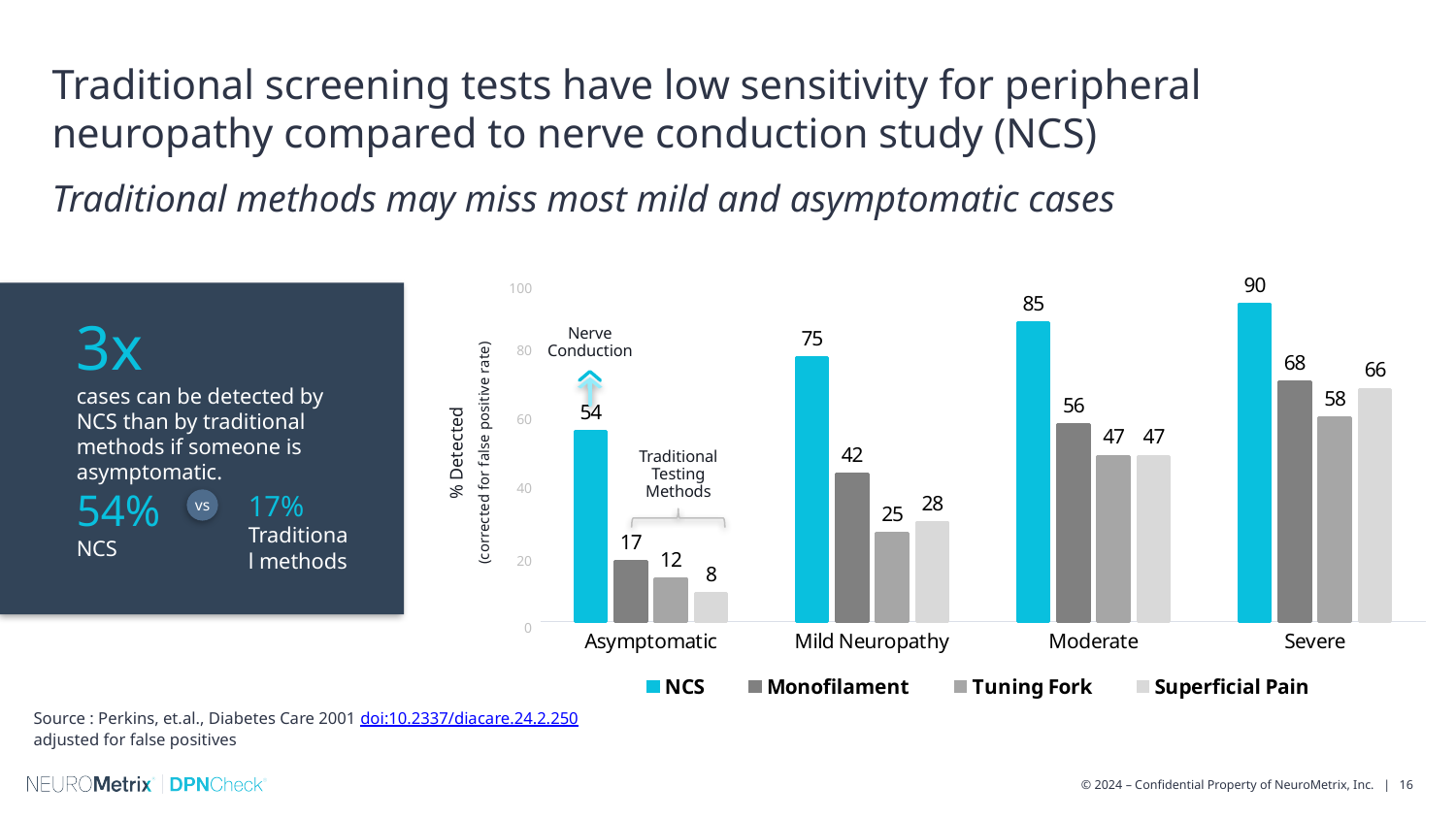
What is the difference between the NCS and Monofilament values for Moderate? 29 What kind of chart is shown on the slide? Bar chart Do the NCS values rise or fall from Asymptomatic to Severe? Rise Is the NCS value for Mild Neuropathy greater or less than 60? greater What is the Tuning Fork value for the Severe category? 58 How many categories are shown on the x axis? 4 What is the Superficial Pain value for Mild Neuropathy? 28 Which is larger for Severe: the Monofilament value or the Superficial Pain value? Monofilament How many series does the legend list? 4 Which series has the lowest value in the Asymptomatic category? Superficial Pain Which category has the highest NCS value? Severe What is the NCS value for the Asymptomatic category? 54